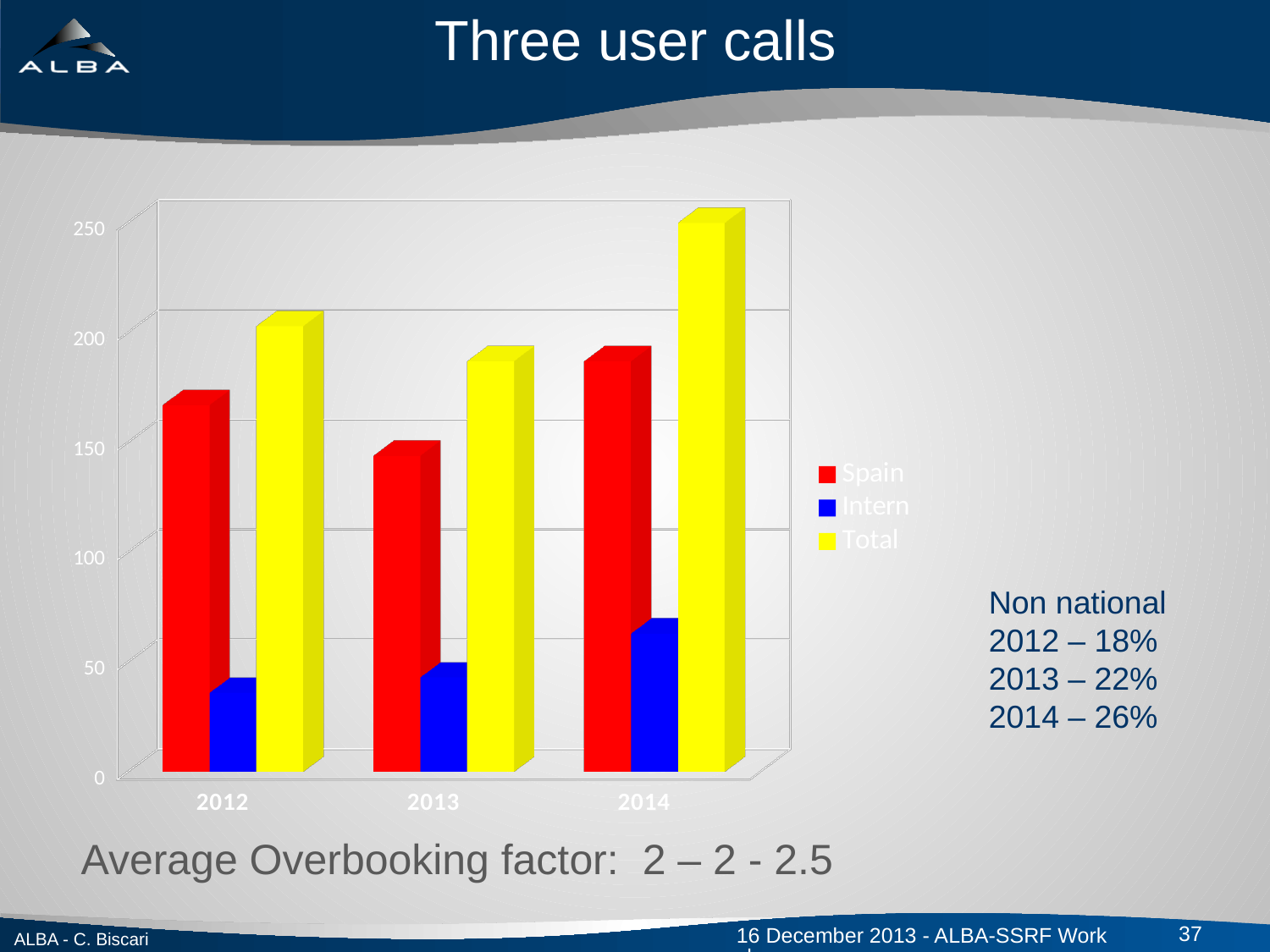
Is the value for Total in 2013 greater or less than 200? less Is the value for Intern in 2014 greater or less than 50? greater Do the Intern values rise or fall from 2012 to 2014? rise How many years are shown on the x axis? 3 What kind of chart is shown on the slide? bar chart Which series is drawn in yellow? Total Is the value for Spain in 2012 greater or less than 150? greater In which year is the Spain bar lowest? 2013 Which is larger in 2014, the Spain bar or the Intern bar? Spain In which year is the Total bar highest? 2014 How many series does the legend list? 3 In which year is the Intern bar lowest? 2012